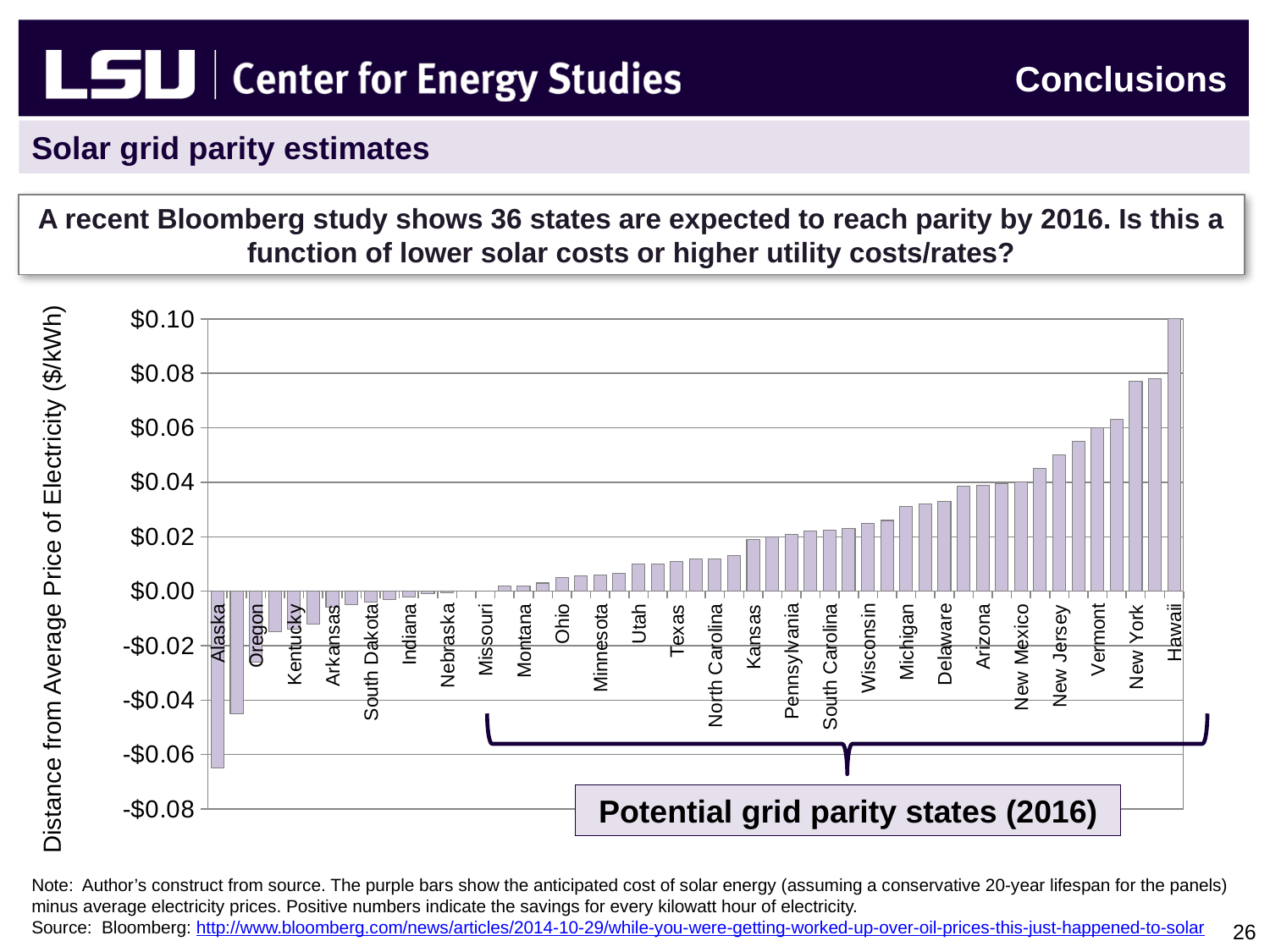
Do the bar values rise or fall moving from left to right along the x axis? rise Is the value for New York greater or less than $0.06? greater Is the value for Michigan greater or less than $0.02? greater Which has the larger value, Hawaii or New York? Hawaii Which state has the lowest value on the chart? Alaska Is the value for Texas greater or less than $0.02? less Which has the larger value, Vermont or Texas? Vermont Which state has the highest value on the chart? Hawaii What kind of chart is shown on the slide? bar chart What is the label on the vertical axis of the chart? Distance from Average Price of Electricity ($/kWh)